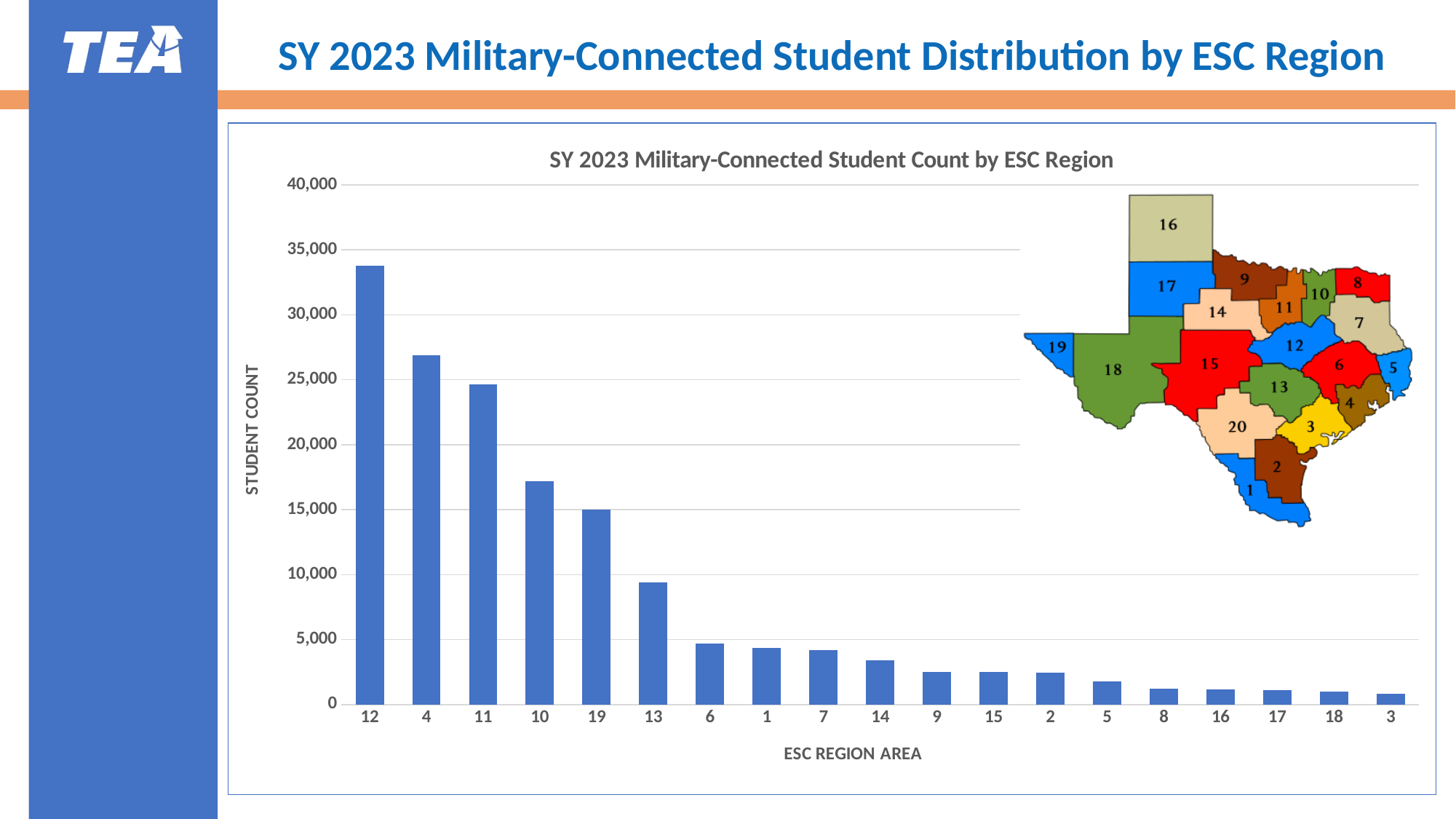
Do the student counts rise or fall moving from left to right along the x axis? fall Which has a higher student count, ESC region 4 or ESC region 11? 4 Which ESC region has the lowest student count? 3 Which ESC region has the highest student count? 12 What kind of chart is shown on the slide? bar chart What is the title of the chart? SY 2023 Military-Connected Student Count by ESC Region Is the student count for ESC region 13 greater or less than 10,000? less How many ESC regions are plotted on the x axis? 19 Is the student count for ESC region 12 greater or less than 30,000? greater Is the student count for ESC region 10 greater or less than 15,000? greater What is the label of the y axis? STUDENT COUNT